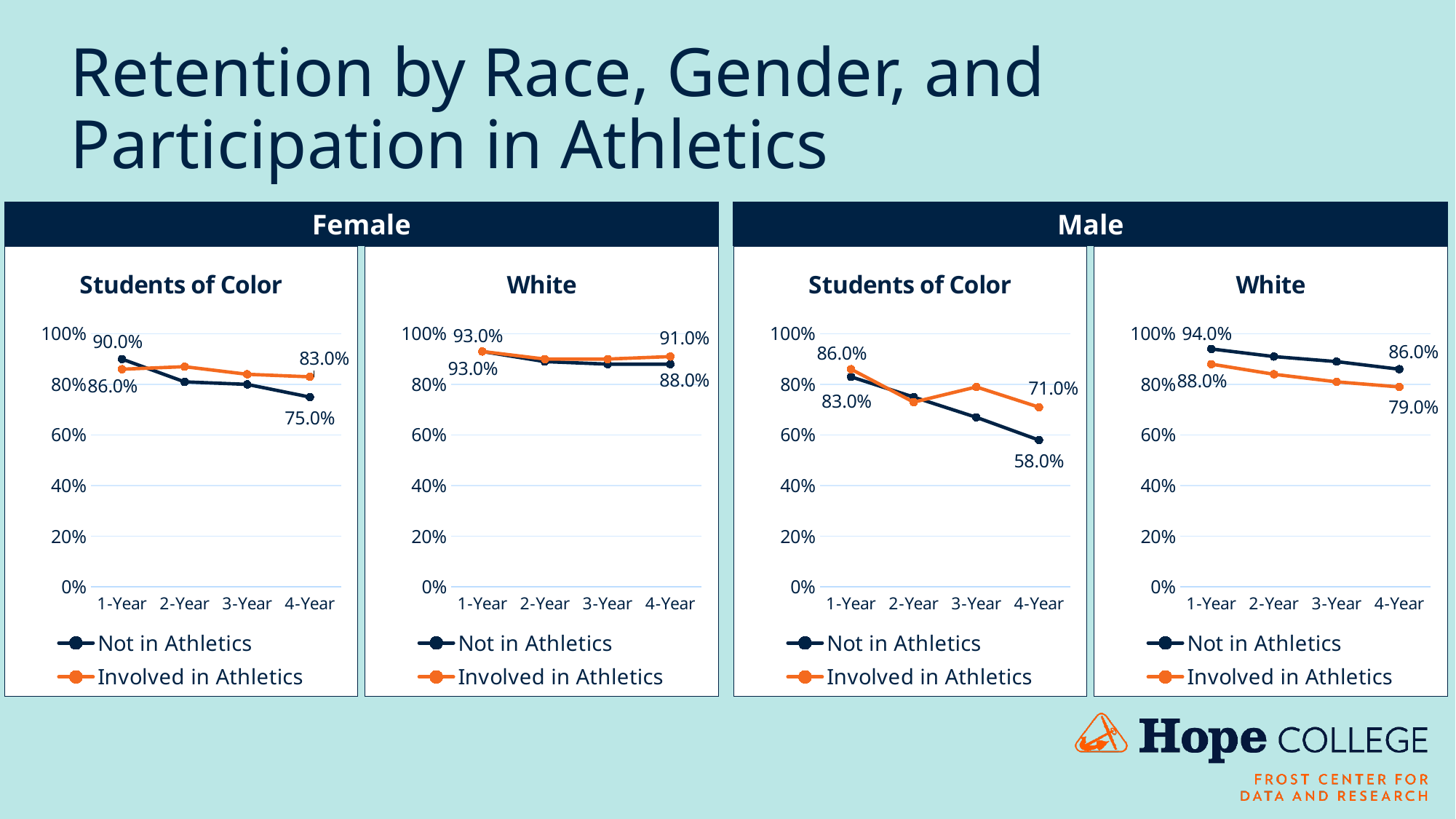
In the Male White chart, what is the 1-Year retention value for Not in Athletics? 94.0% In the Male Students of Color chart, does the Not in Athletics series rise or fall from 1-Year to 4-Year? fall In the Male Students of Color chart, what is the 4-Year retention value for Not in Athletics? 58.0% In the Female Students of Color chart, what is the 1-Year retention value for Involved in Athletics? 86.0% What kind of chart is the Female Students of Color chart? line chart In the Male Students of Color chart, what is the difference between the 4-Year values for Involved in Athletics and Not in Athletics? 13.0% How many series does the legend list in the Female White chart? 2 How many categories are on the x axis of the Male White chart? 4 In the Female White chart, what is the 4-Year retention value for Involved in Athletics? 91.0% In the Female Students of Color chart, what is the 4-Year retention value for Not in Athletics? 75.0% In the Female Students of Color chart, is the 3-Year value for Not in Athletics greater or less than 60%? greater In the Male White chart, which series has the higher 4-Year value, Not in Athletics or Involved in Athletics? Not in Athletics